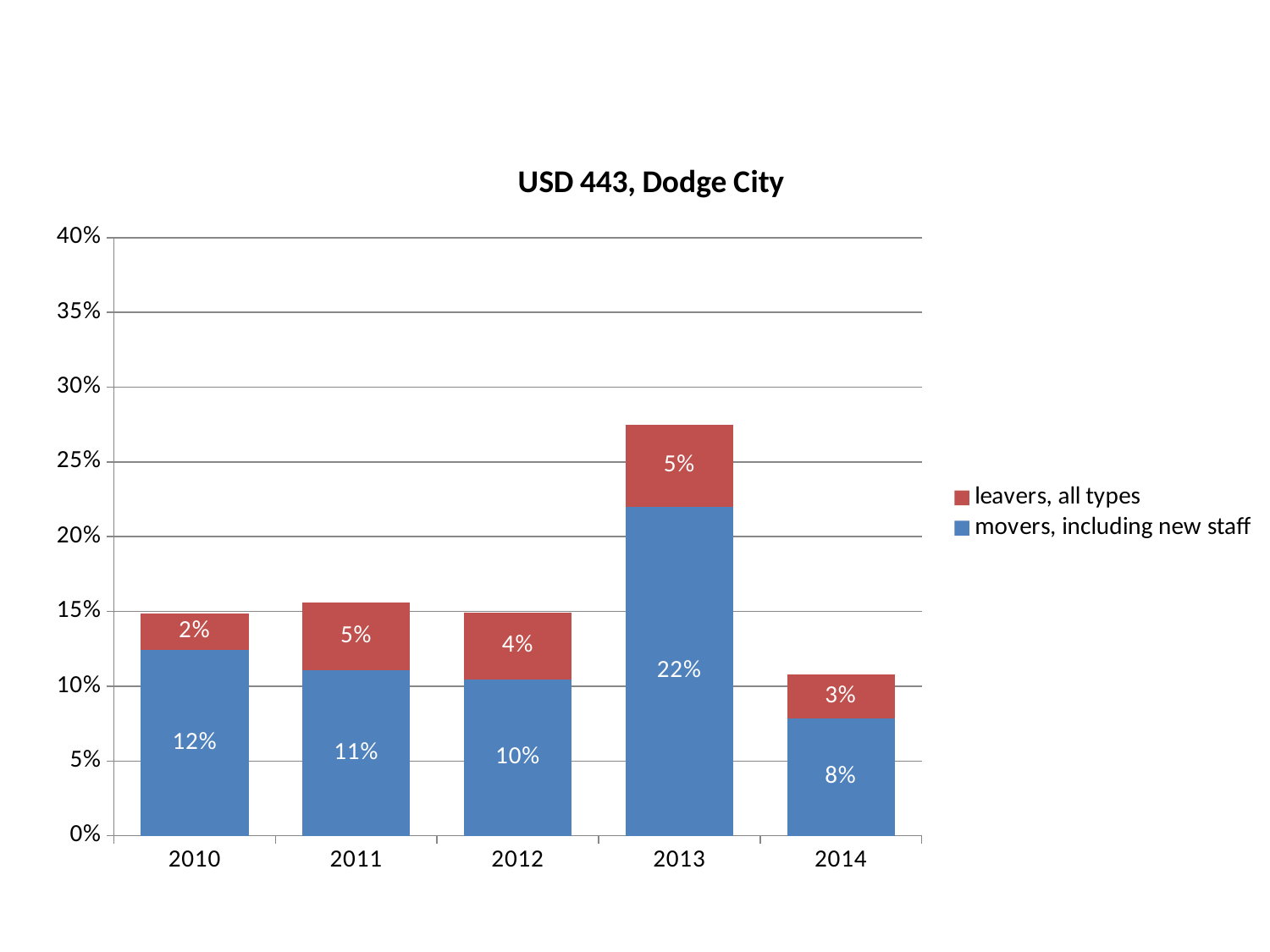
Which is larger, the movers, including new staff value for 2010 or for 2011? 2010 In which year is the value for movers, including new staff highest? 2013 What is the value for leavers, all types in 2010? 2% What kind of chart is shown on the slide? stacked bar chart How many series does the legend list? 2 Is the total stacked bar for 2013 greater or less than 25%? greater In which year is the value for movers, including new staff lowest? 2014 In which year is the value for leavers, all types lowest? 2010 How many years are shown on the x axis? 5 What is the difference between the movers, including new staff values for 2013 and 2014? 14% What is the value for movers, including new staff in 2014? 8% What is the value for movers, including new staff in 2013? 22%